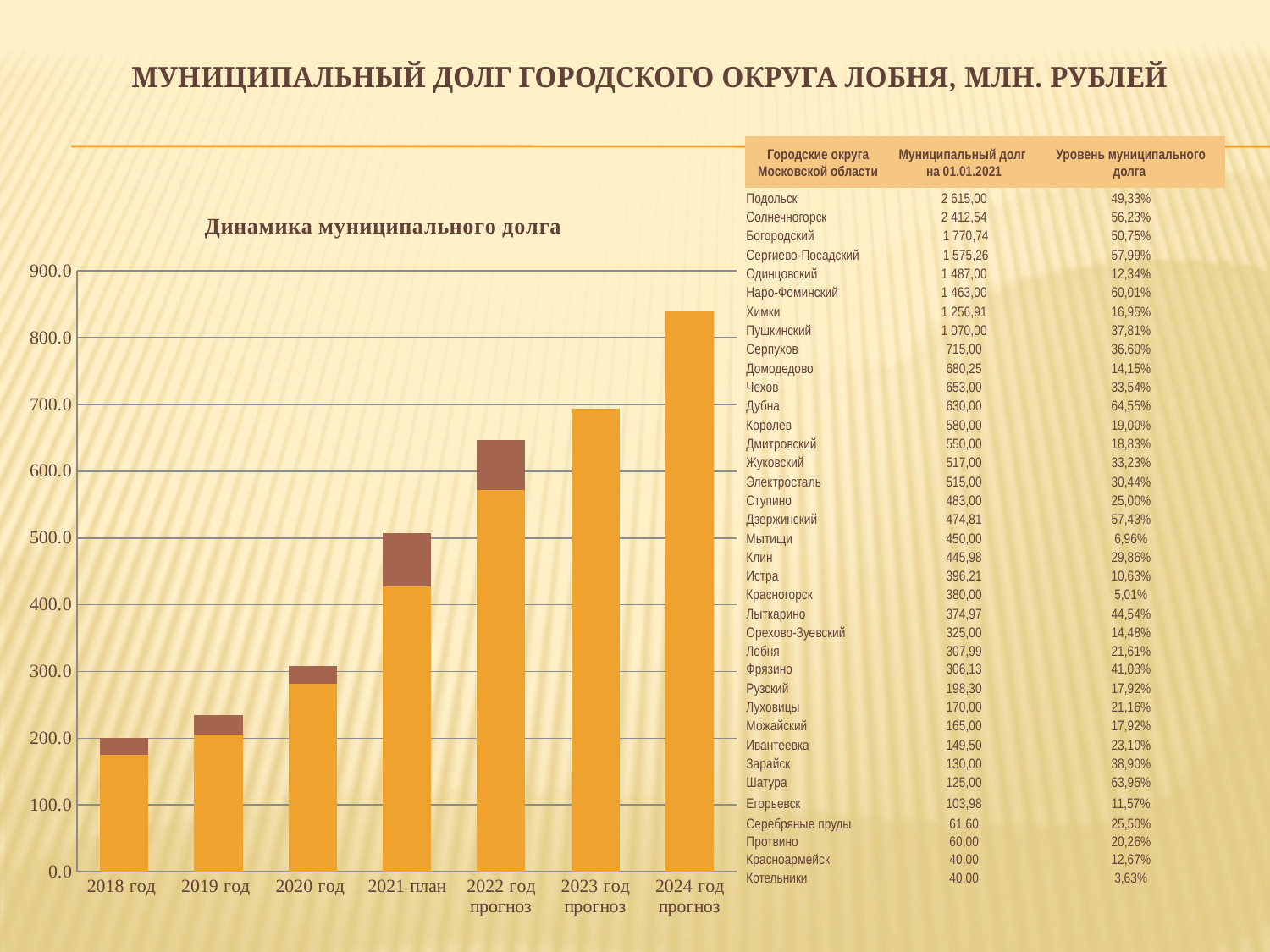
In the chart "Динамика муниципального долга", is the total bar for 2022 год прогноз greater or less than 600.0? greater What is the highest value shown on the y axis of the chart "Динамика муниципального долга"? 900.0 In the chart "Динамика муниципального долга", is the total bar for 2024 год прогноз greater or less than 800.0? greater In the chart "Динамика муниципального долга", which bar is taller: 2021 план or 2020 год? 2021 план What is the title of the bar chart on the slide? Динамика муниципального долга What kind of chart is "Динамика муниципального долга"? bar chart In the chart "Динамика муниципального долга", do the bar heights rise or fall from 2018 год to 2024 год прогноз? rise In the chart "Динамика муниципального долга", is the total bar for 2018 год greater or less than 300.0? less How many categories are shown on the x axis of the chart "Динамика муниципального долга"? 7 Which category has the highest bar in the chart "Динамика муниципального долга"? 2024 год прогноз Which category has the lowest bar in the chart "Динамика муниципального долга"? 2018 год